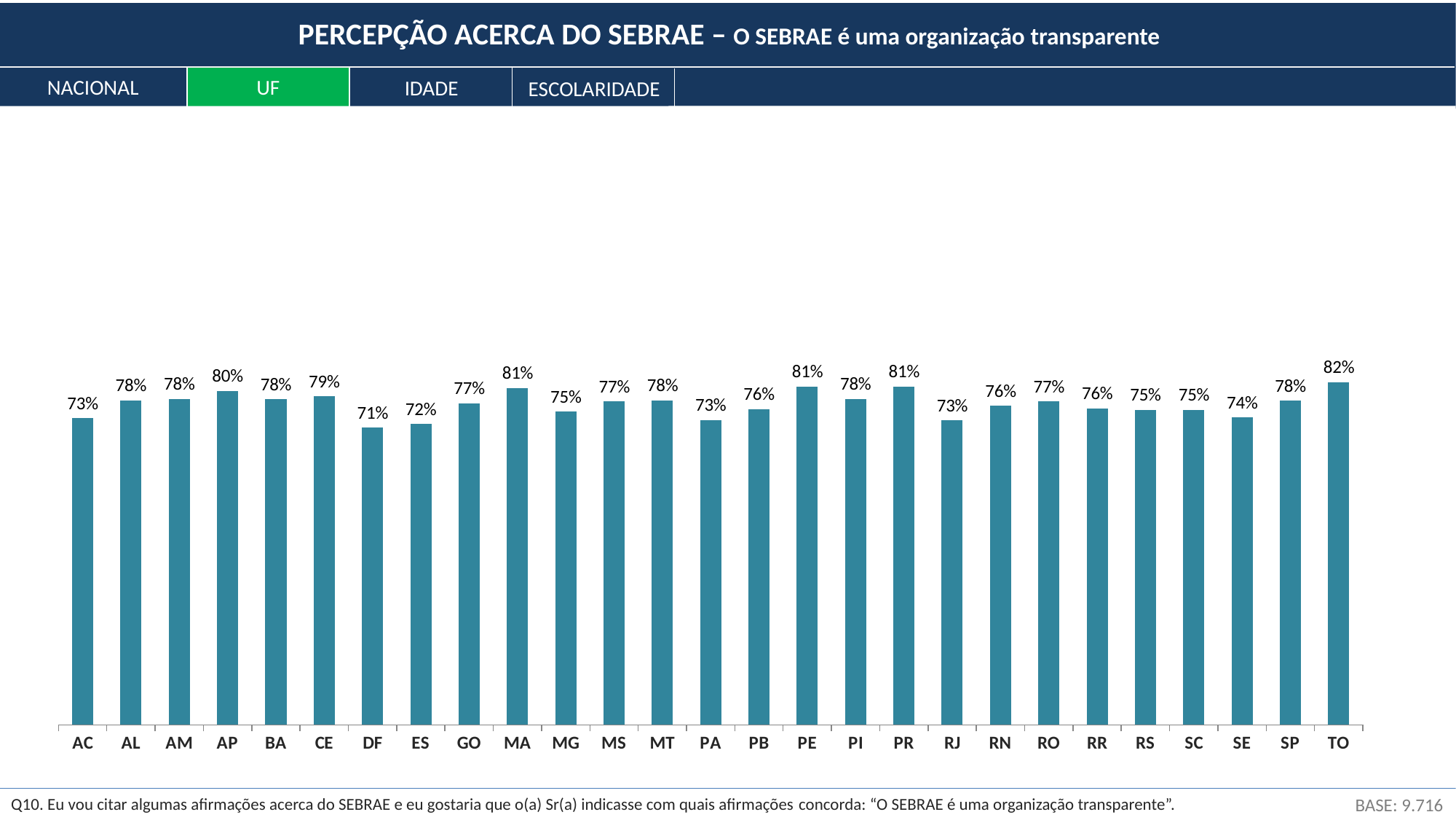
How many states are shown on the x axis? 27 Which state has the lowest value? DF Which tab is highlighted in green below the title? UF What is the value for SE? 74% What is the value for MA? 81% Which is larger, the value for CE or the value for ES? CE What is the difference between the values for AP and AC? 7% Which state has the highest value? TO What is the value for SP? 78% What is the difference between the values for TO and DF? 11% What kind of chart is shown on the slide? Bar chart What is the value for DF? 71%